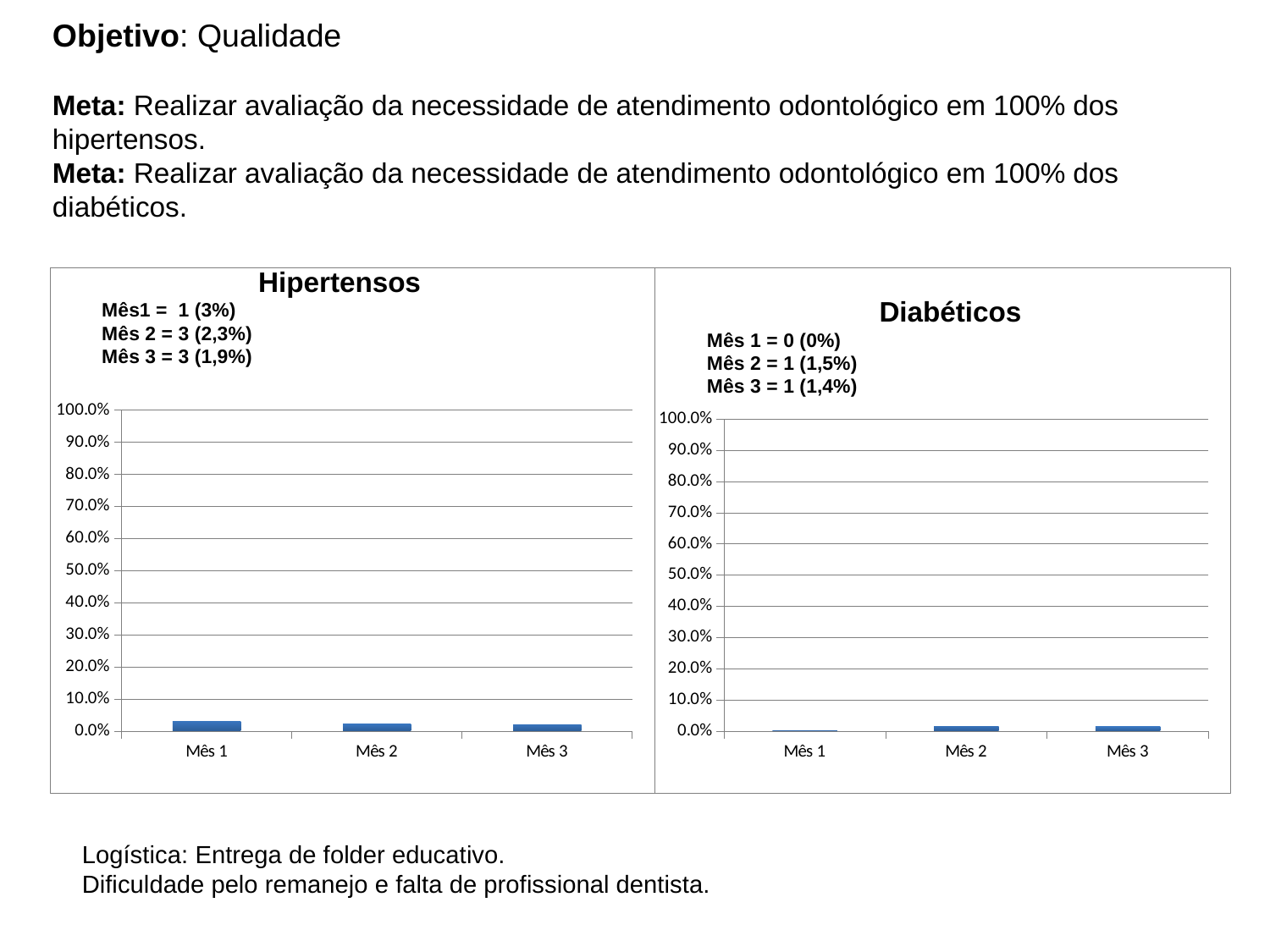
In the Hipertensos chart, what percentage is given for Mês 3? 1,9% In the Hipertensos chart, do the values rise or fall from Mês 1 to Mês 3? fall In the Diabéticos chart, what percentage is given for Mês 1? 0% What type of chart is the Hipertensos chart? bar chart In the Diabéticos chart, which month has the lowest value? Mês 1 In the Diabéticos chart, what percentage is given for Mês 2? 1,5% How many months are shown on the x axis of the Diabéticos chart? 3 In the Hipertensos chart, is the value for Mês 1 greater or less than 10.0%? less In the Hipertensos chart, what percentage is given for Mês 1? 3% What is the title of the chart on the right side of the slide? Diabéticos In the Hipertensos chart, what is the difference between the percentages for Mês 1 and Mês 3? 1,1% In the Hipertensos chart, which month has the highest value? Mês 1